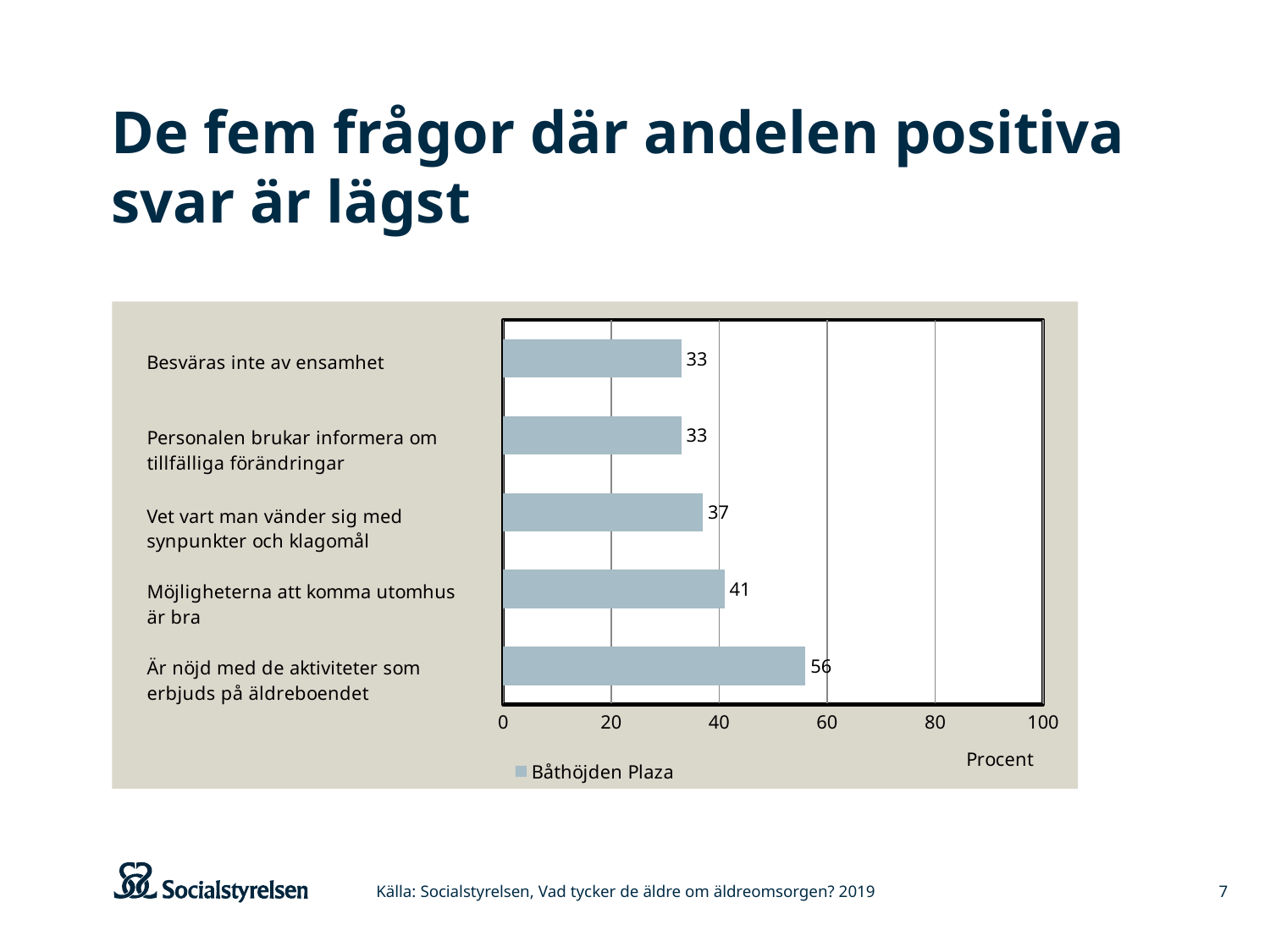
What is the value for "Vet vart man vänder sig med synpunkter och klagomål"? 37 How many series does the legend list? 1 Which category has the highest value? Är nöjd med de aktiviteter som erbjuds på äldreboendet What is the value for "Besväras inte av ensamhet"? 33 What is the difference between the values for "Är nöjd med de aktiviteter som erbjuds på äldreboendet" and "Möjligheterna att komma utomhus är bra"? 15 What kind of chart is shown on the slide? bar chart Which is larger: the value for "Vet vart man vänder sig med synpunkter och klagomål" or the value for "Personalen brukar informera om tillfälliga förändringar"? Vet vart man vänder sig med synpunkter och klagomål What series name is shown in the chart legend? Båthöjden Plaza What is the value for "Möjligheterna att komma utomhus är bra"? 41 Is the value for "Är nöjd med de aktiviteter som erbjuds på äldreboendet" greater or less than 40? greater What is the value for "Är nöjd med de aktiviteter som erbjuds på äldreboendet"? 56 How many categories are shown in the chart? 5